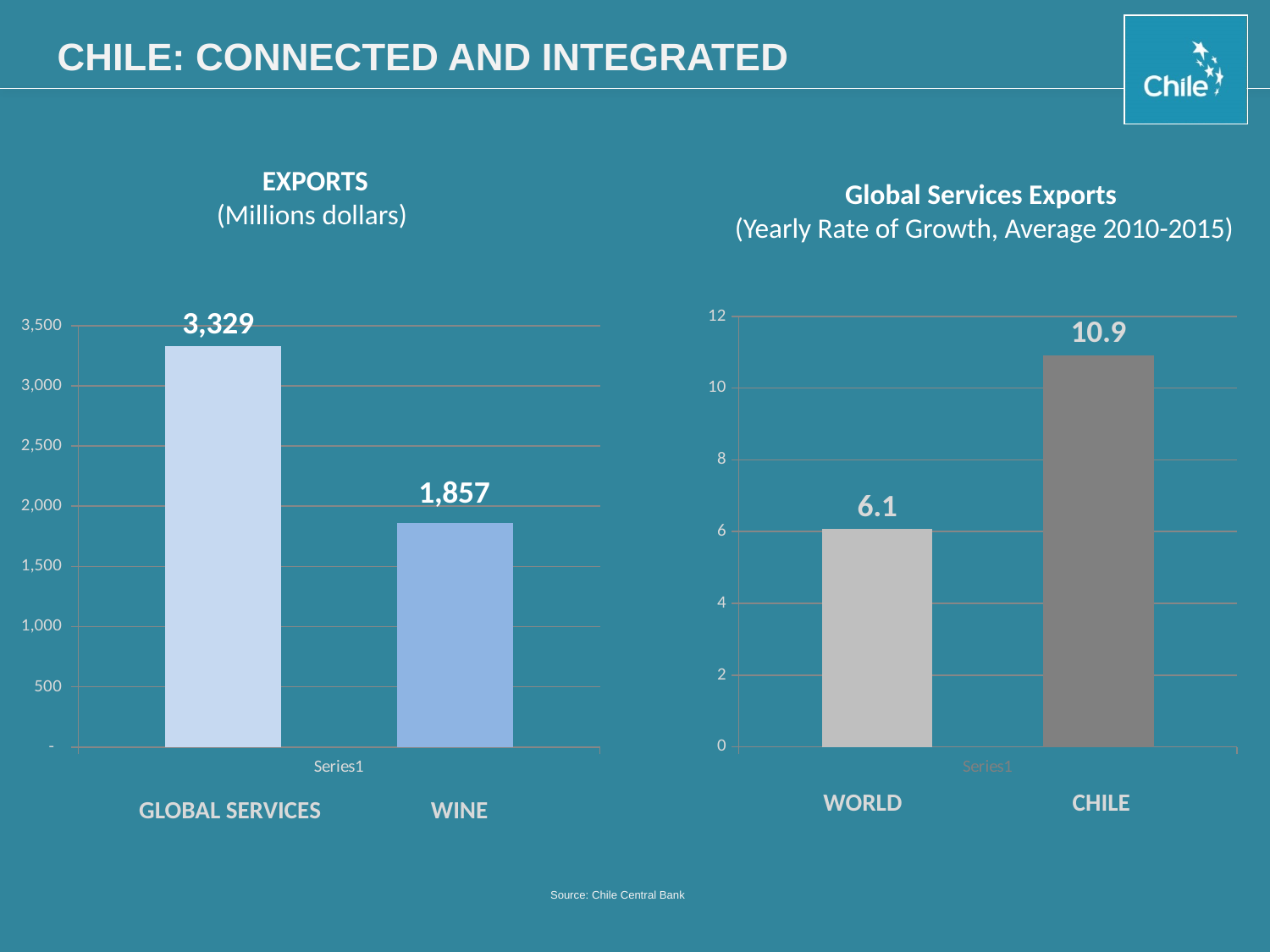
In the Global Services Exports chart, what is the difference between CHILE and WORLD? 4.8 In the EXPORTS (Millions dollars) chart, how many bars are shown? 2 In the EXPORTS (Millions dollars) chart, what is the value for WINE? 1,857 In the EXPORTS (Millions dollars) chart, what is the value for GLOBAL SERVICES? 3,329 What type of chart is the Global Services Exports chart? Bar chart In the EXPORTS (Millions dollars) chart, is the value for WINE greater or less than 2,000? less In the Global Services Exports chart, what is the value for WORLD? 6.1 In the Global Services Exports chart, which category has the lower value? WORLD In the Global Services Exports chart, is the value for CHILE greater or less than 10? greater In the EXPORTS (Millions dollars) chart, what is the difference between GLOBAL SERVICES and WINE? 1,472 In the Global Services Exports chart, what is the value for CHILE? 10.9 In the EXPORTS (Millions dollars) chart, which category has the higher value? GLOBAL SERVICES